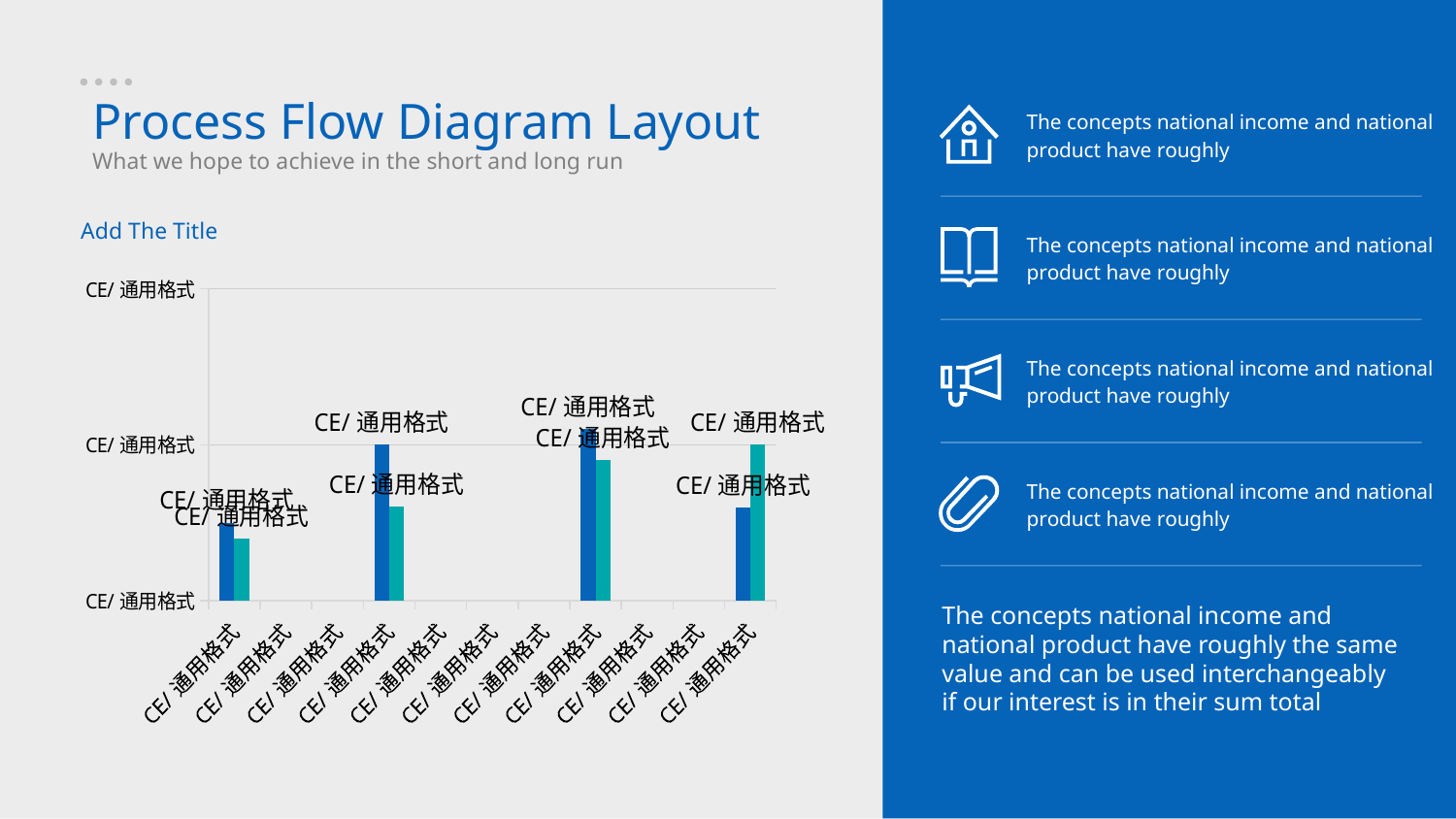
Which group of bars, counting from the left, contains the shortest bar in the chart? the first (leftmost) group How many groups of bars are plotted in the chart? 4 What kind of chart is shown on the slide? bar chart In the second group of bars from the left, which bar is taller, the dark blue one or the teal one? dark blue In the rightmost group of bars, which bar is taller, the dark blue one or the teal one? teal How many bars are plotted in the chart in total? 8 How many different bar colours are used in the chart? 2 What is the heading printed directly above the chart? Add The Title In the leftmost group of bars, which bar is shorter, the dark blue one or the teal one? teal